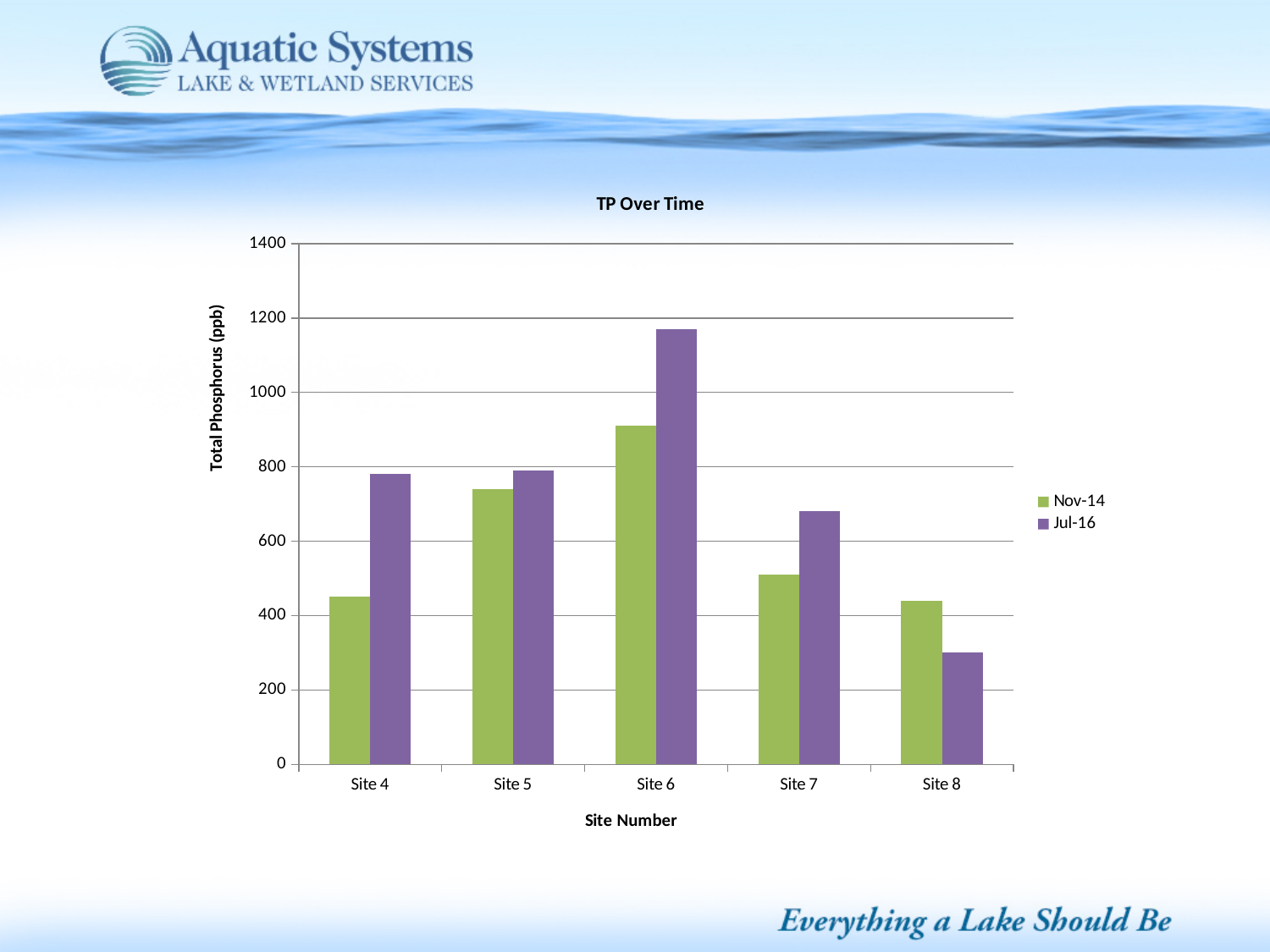
At Site 4, which is larger, the Nov-14 value or the Jul-16 value? Jul-16 Is the Jul-16 value for Site 6 greater or less than 1000? greater How many series does the legend list? 2 Is the Nov-14 value for Site 4 greater or less than 600? less Which site has the highest Jul-16 value? Site 6 What is the title of the chart? TP Over Time How many sites are shown on the x axis? 5 What kind of chart is shown on the slide? bar chart Which site has the lowest Jul-16 value? Site 8 Which site has the highest Nov-14 value? Site 6 Is the Jul-16 value for Site 8 greater or less than 400? less At Site 8, which is larger, the Nov-14 value or the Jul-16 value? Nov-14